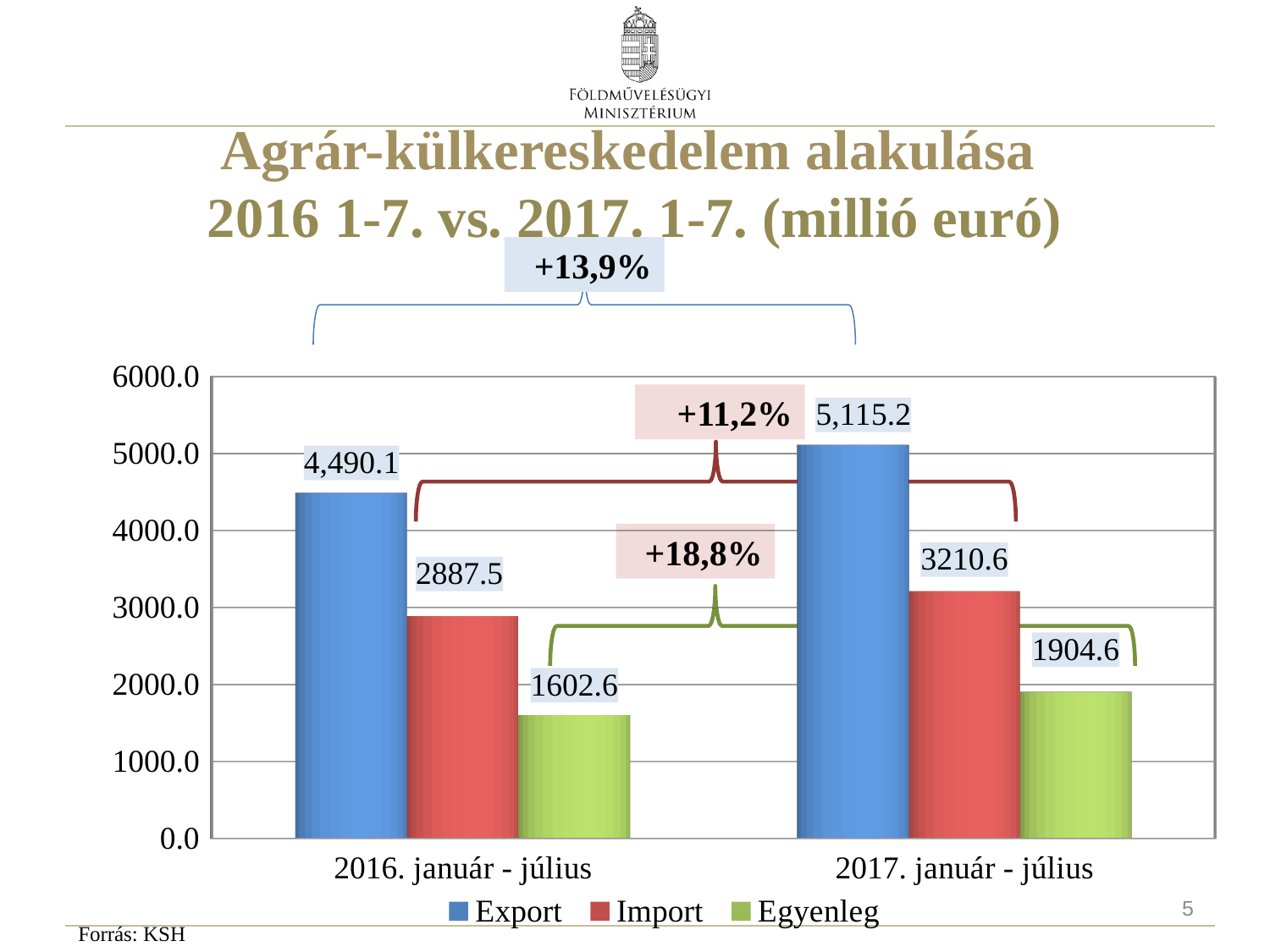
Which series has the lowest value in 2016. január - július? Egyenleg What is the Export value for 2016. január - július? 4,490.1 What is the Egyenleg value for 2016. január - július? 1602.6 Which is larger, the Egyenleg value for 2016. január - július or for 2017. január - július? 2017. január - július What is the difference between the Export values for 2017. január - július and 2016. január - július? 625.1 What is the Export value for 2017. január - július? 5,115.2 What is the difference between the Import values for 2017. január - július and 2016. január - július? 323.1 What percentage change is shown for Import between the two periods? +11,2% How many series does the legend list? 3 What kind of chart is shown on the slide? Bar chart Which series has the highest value in 2017. január - július? Export What is the Import value for 2017. január - július? 3210.6